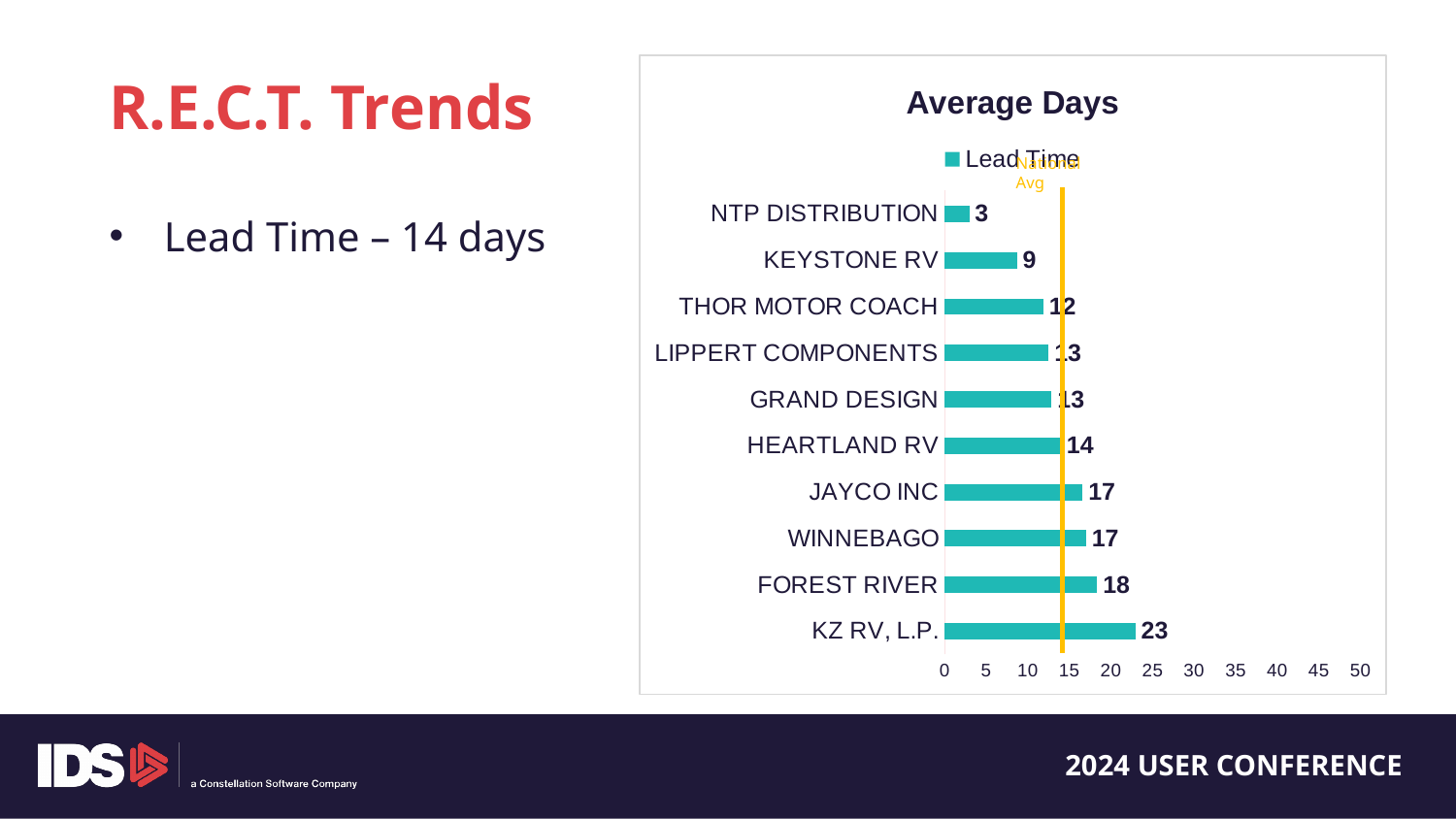
What is the Lead Time value for FOREST RIVER? 18 What type of chart is shown on the slide? bar chart What is the difference between the Lead Time for KZ RV, L.P. and KEYSTONE RV? 14 Which has a larger Lead Time, JAYCO INC or KEYSTONE RV? JAYCO INC What is the Lead Time value for KZ RV, L.P.? 23 What is the Lead Time value for NTP DISTRIBUTION? 3 What is the Lead Time value for HEARTLAND RV? 14 How many categories are plotted in the chart? 10 Which category has the highest Lead Time? KZ RV, L.P. Is the Lead Time for WINNEBAGO greater or less than 15? greater What is the title of the chart? Average Days Which category has the lowest Lead Time? NTP DISTRIBUTION